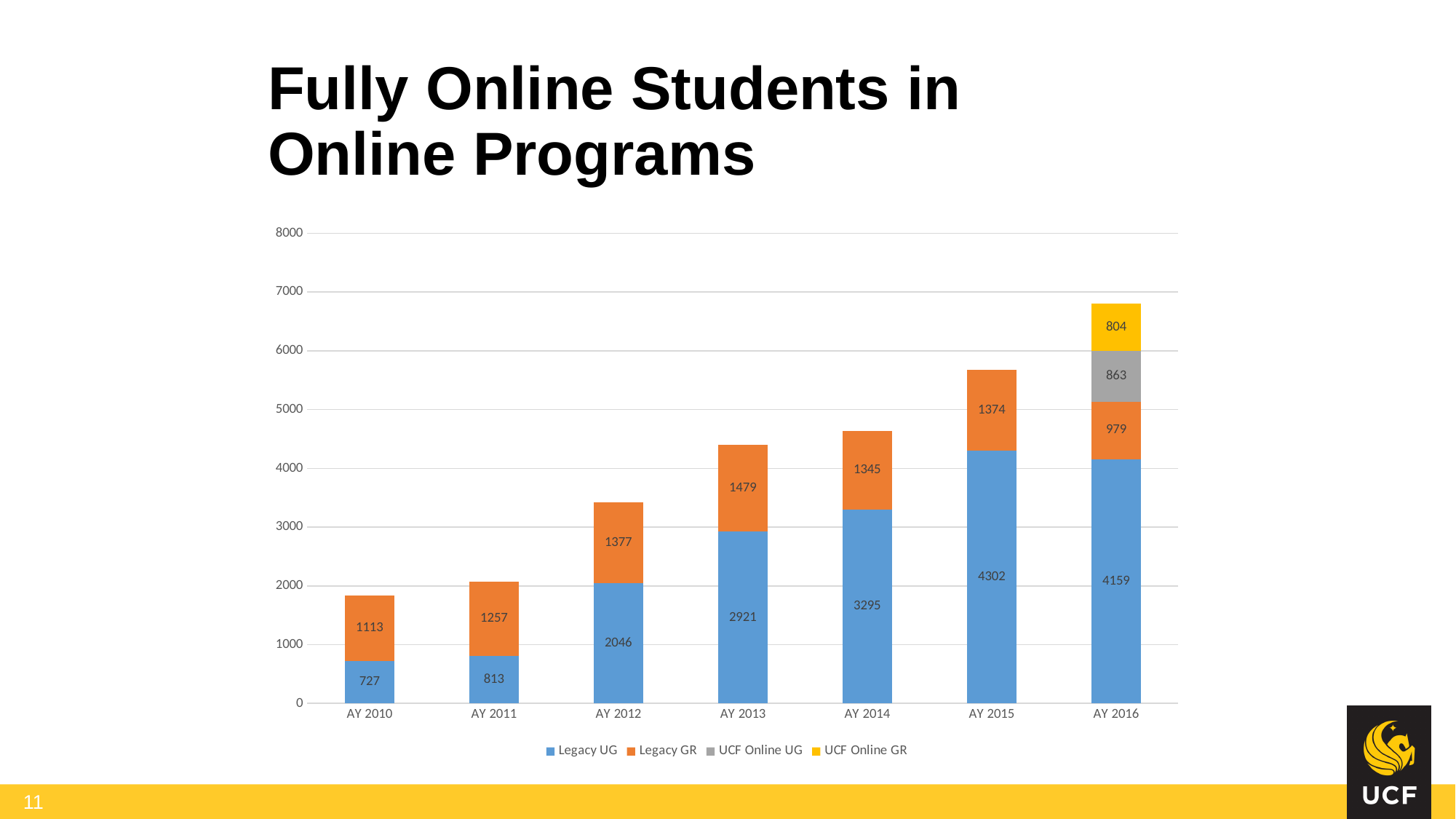
What is the difference between the Legacy UG values for AY 2015 and AY 2016? 143 Which is larger, the Legacy GR value for AY 2013 or for AY 2014? AY 2013 What is the Legacy UG value for AY 2014? 3295 What is the UCF Online GR value for AY 2016? 804 How many academic years are shown on the x axis? 7 What is the Legacy GR value for AY 2012? 1377 How many series does the legend list? 4 What is the total of the stacked bar for AY 2010? 1840 What kind of chart is shown on the slide? stacked bar chart Which academic year has the highest Legacy UG value? AY 2015 Which academic year has the lowest Legacy UG value? AY 2010 Is the total stacked bar for AY 2015 greater or less than 5000? greater